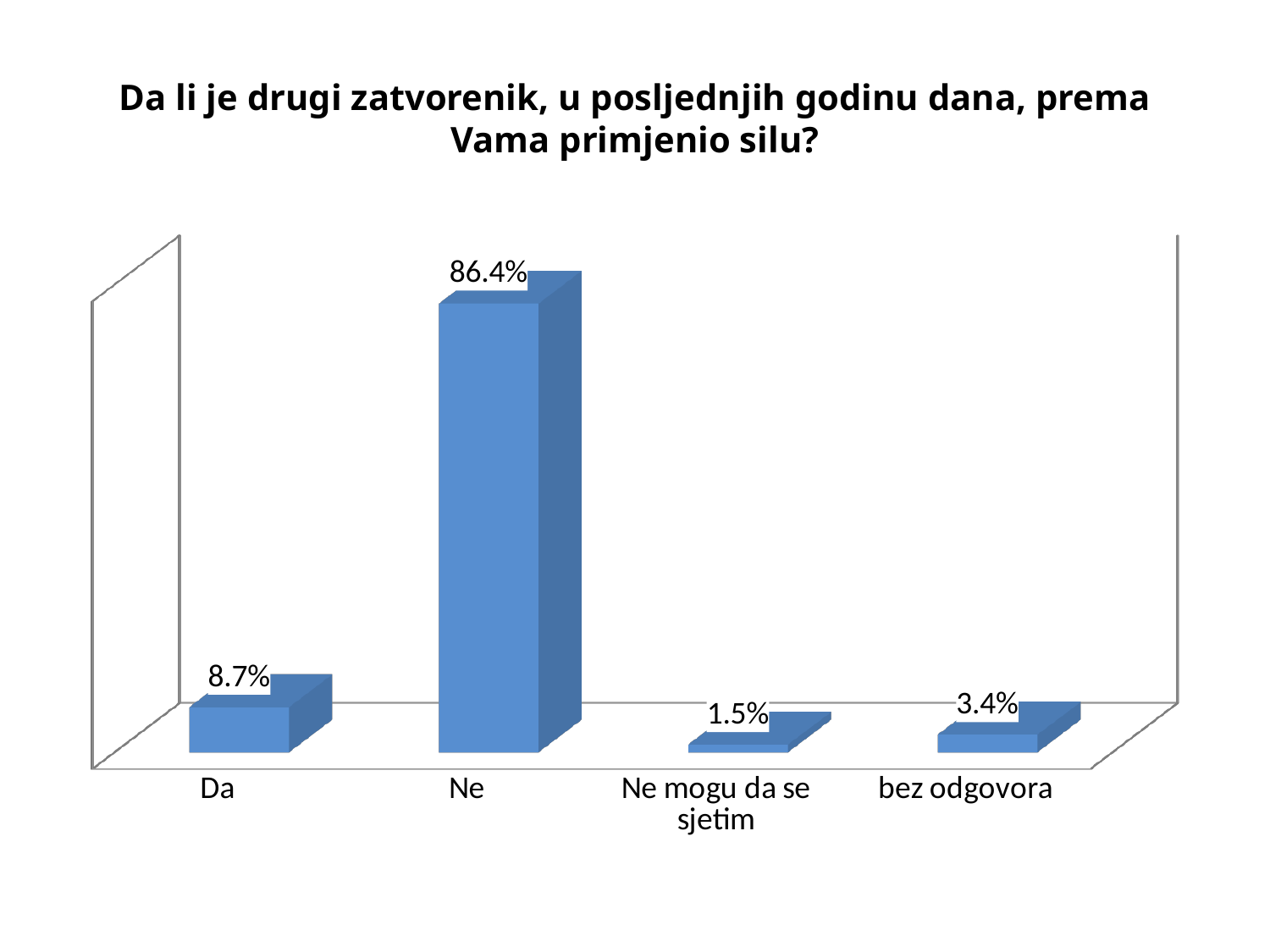
What is the value for "Ne"? 86.4% What kind of chart is shown on the slide? Bar chart What is the value for "Da"? 8.7% What is the difference between the values for "Ne" and "Da"? 77.7% What is the value for "bez odgovora"? 3.4% How many categories are shown on the chart? 4 What is the difference between the values for "bez odgovora" and "Ne mogu da se sjetim"? 1.9% Which category has the lowest value? Ne mogu da se sjetim What is the title of the chart? Da li je drugi zatvorenik, u posljednjih godinu dana, prema Vama primjenio silu? What is the value for "Ne mogu da se sjetim"? 1.5% Which category has the highest value? Ne Which is larger, the value for "Da" or the value for "bez odgovora"? Da